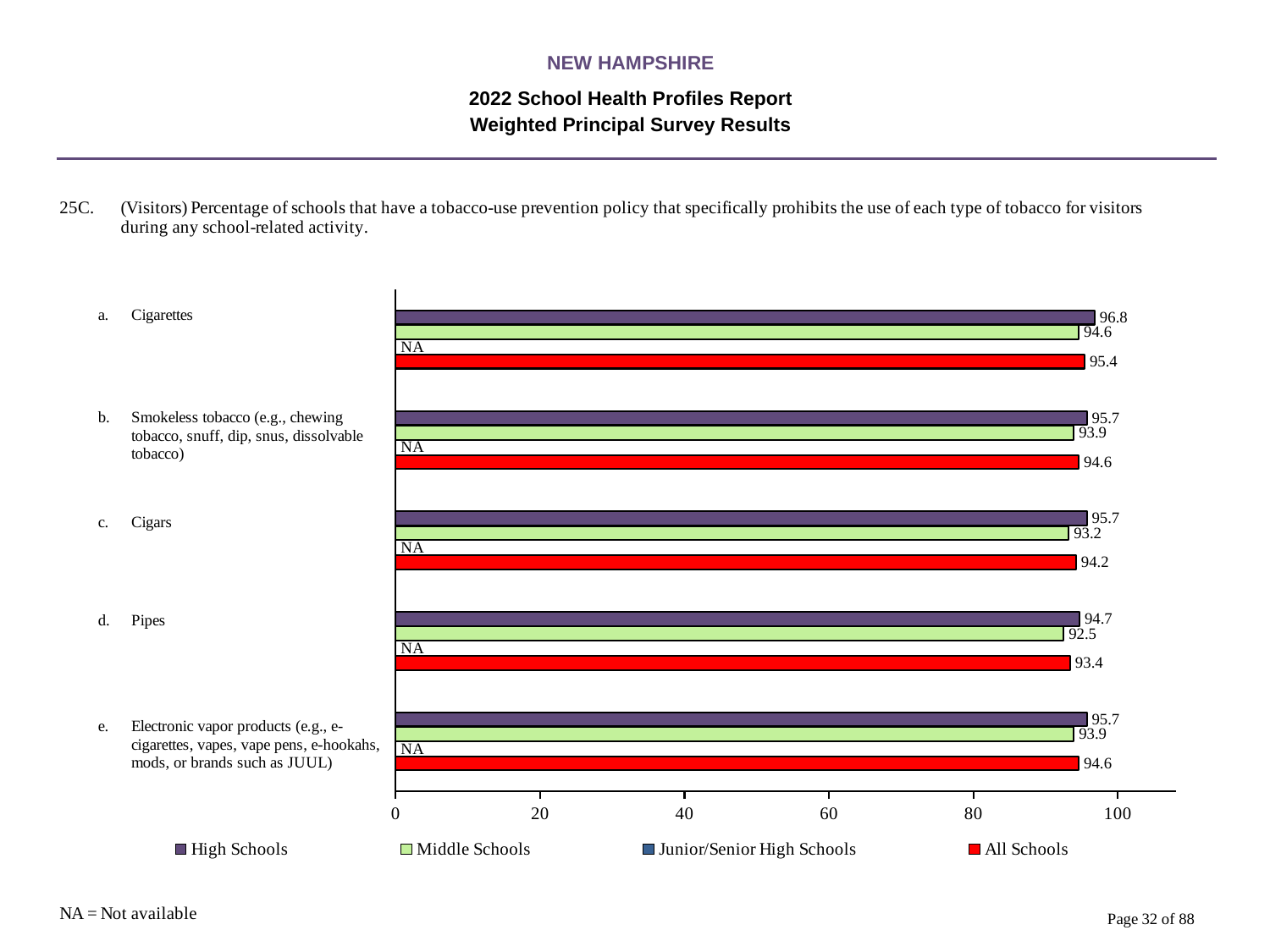
What kind of chart is shown on the slide? Bar chart What is the difference between the High Schools and Middle Schools values for Cigarettes? 2.2 How many categories are shown on the chart? 5 What colour are the All Schools bars? Red Which is larger for Pipes: the High Schools value or the All Schools value? High Schools What is the value for Middle Schools for Pipes? 92.5 What is the value for High Schools for Cigarettes? 96.8 How many series does the legend list? 4 Which category has the lowest All Schools value? Pipes What is the value for Junior/Senior High Schools for Smokeless tobacco? NA What is the value for All Schools for Cigars? 94.2 Which category has the highest High Schools value? Cigarettes